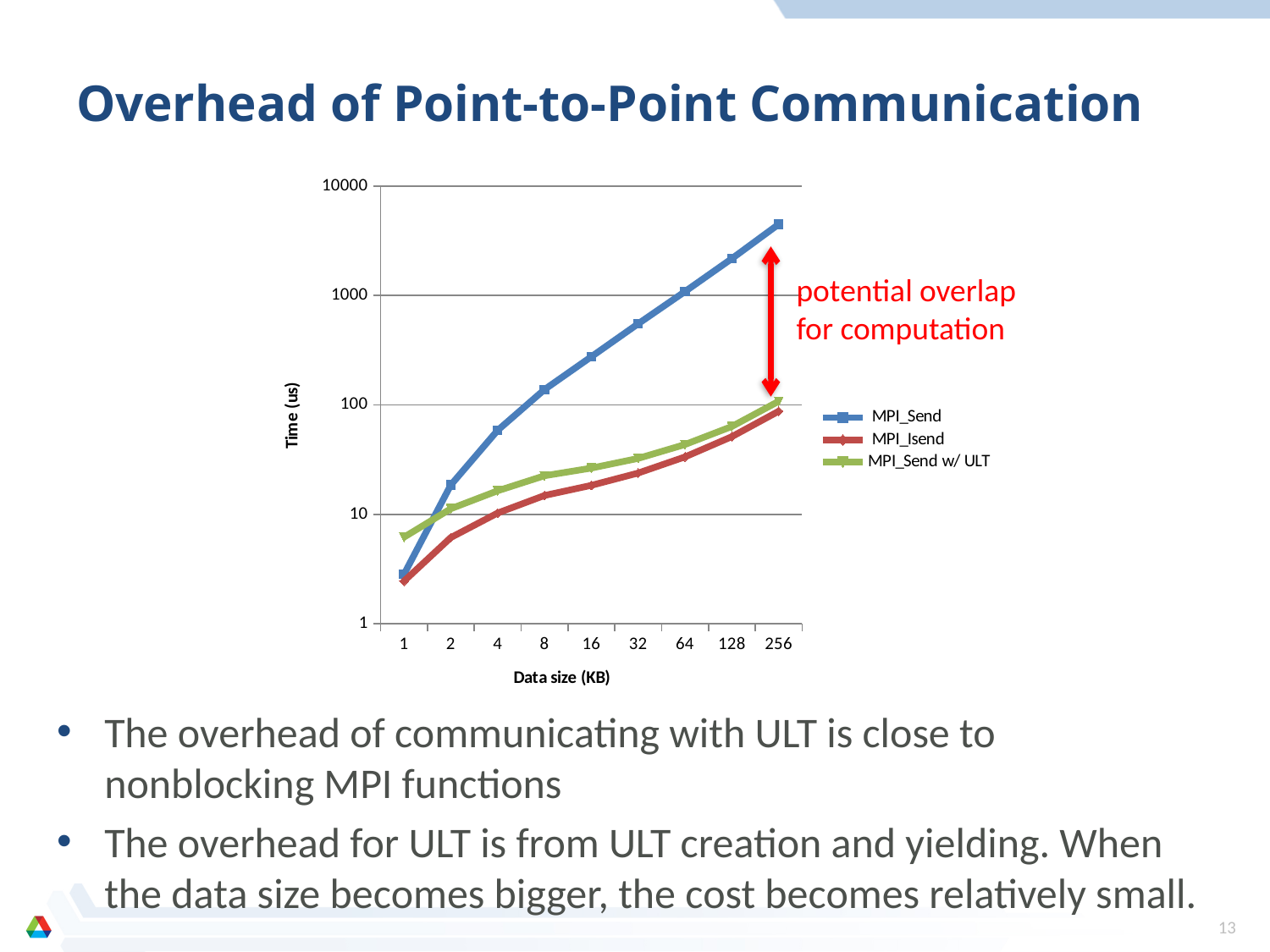
Is the MPI_Send value at 256 KB greater or less than 1000? greater How many data sizes are plotted along the x axis? 9 At 1 KB, which is larger: MPI_Send w/ ULT or MPI_Send? MPI_Send w/ ULT How many series does the chart legend list? 3 Does the MPI_Send series rise or fall as the data size increases? rises What is the label of the x axis? Data size (KB) Is the MPI_Send value at 1 KB greater or less than 10? less Is the MPI_Send value at 8 KB greater or less than 100? greater What is the label of the y axis? Time (us) What kind of chart is shown on the slide? line chart Which series has the highest value at 256 KB? MPI_Send